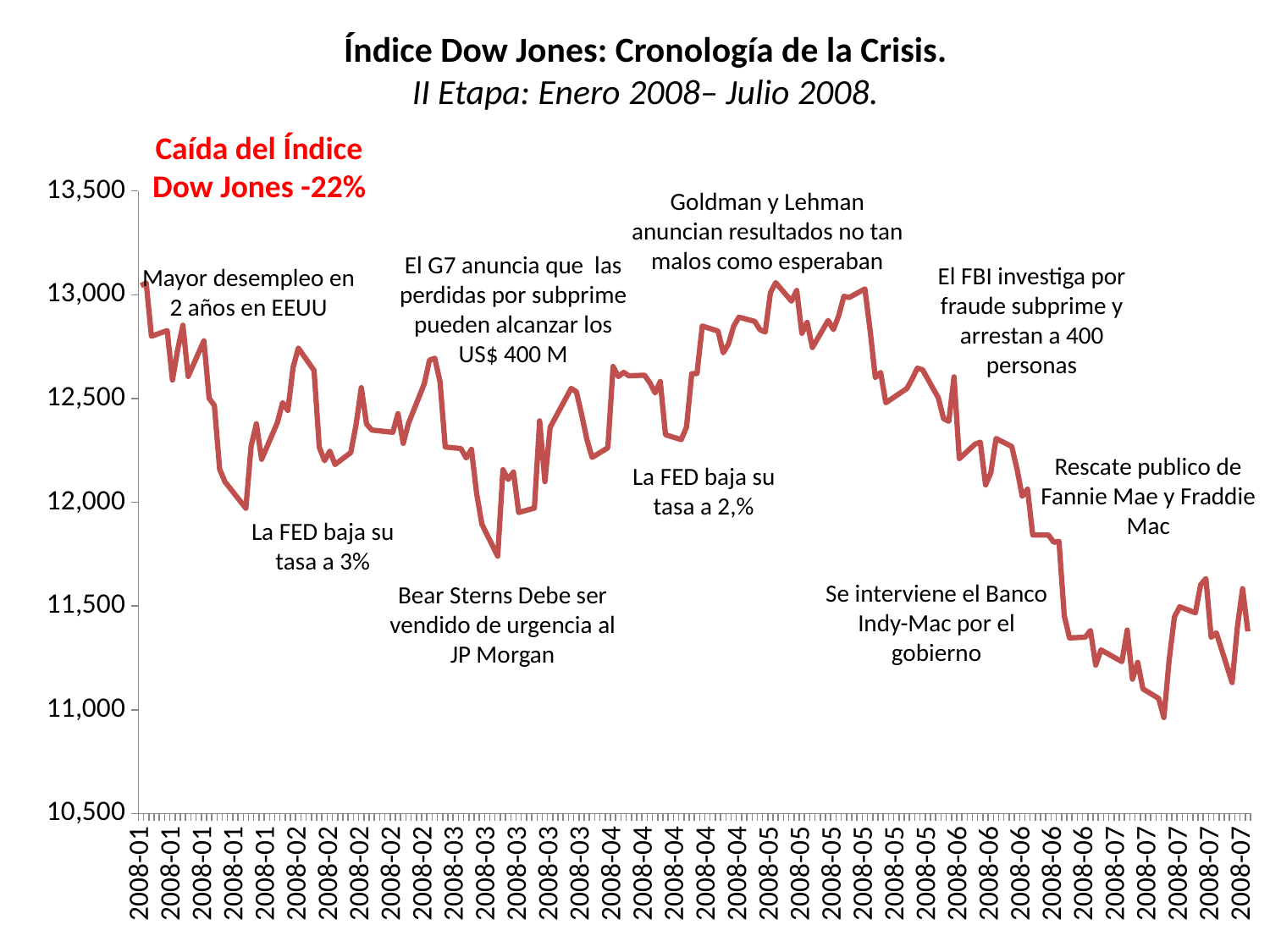
Is the peak value of the index in 2008-05 greater or less than 12,500? greater Is the index higher at the start of January 2008 or at the end of July 2008? start of January 2008 Overall, does the Dow Jones index rise or fall from January 2008 to July 2008? fall Which is lower: the lowest point of the index in March 2008 or the lowest point in July 2008? July 2008 What kind of chart is shown on the slide? line chart Is the lowest value of the index in 2008-03 greater or less than 12,000? less What period does the chart's subtitle say the second stage covers? Enero 2008 – Julio 2008 Is the lowest value of the index in 2008-07 greater or less than 11,500? less How many data series are plotted on the chart? 1 According to the red text on the slide, by what percentage did the Dow Jones index fall? -22%